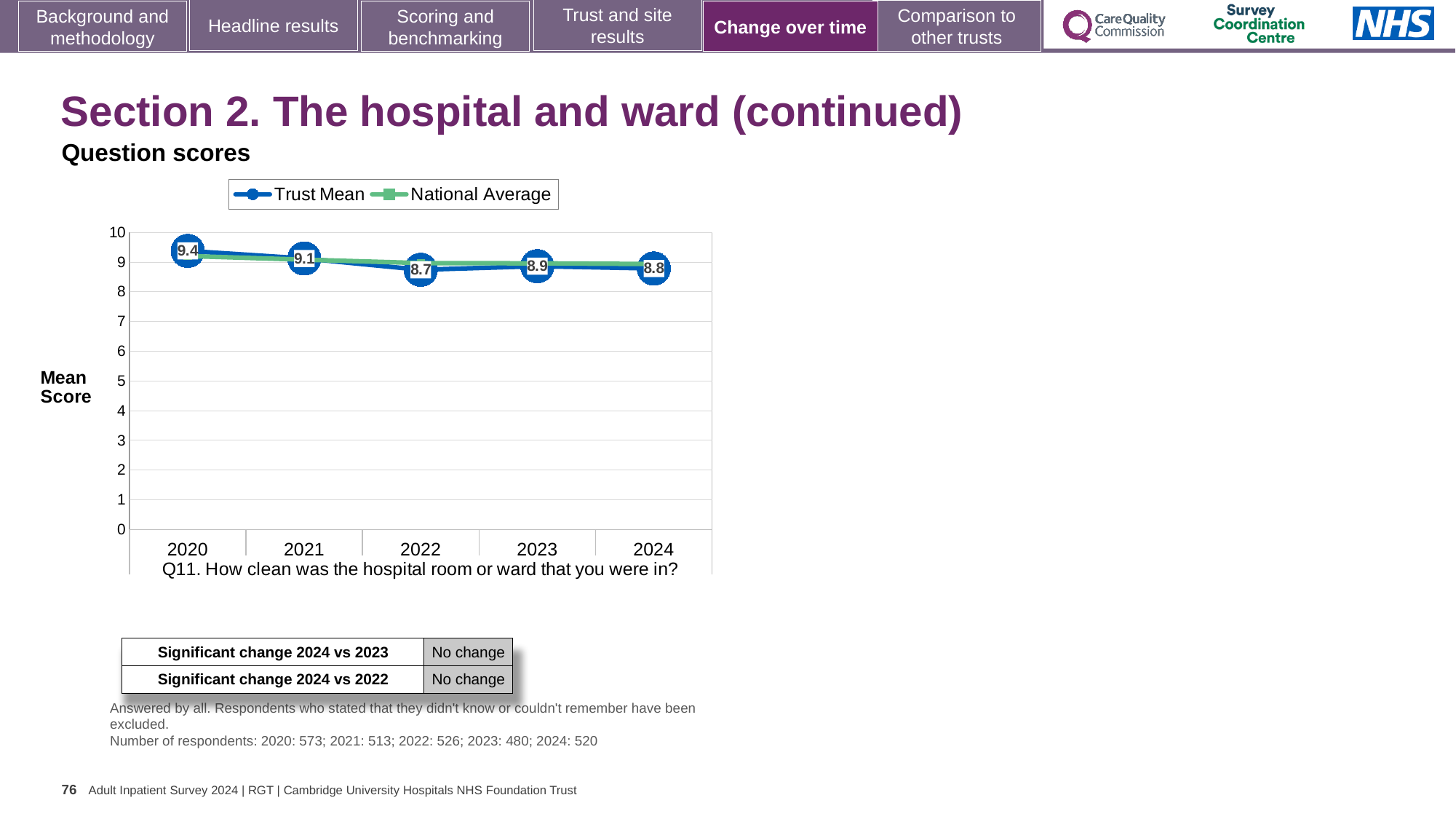
What kind of chart is shown on the slide? Line chart What is the Trust Mean score for 2024? 8.8 How many years are shown on the x axis of the chart? 5 Does the Trust Mean score rise or fall from 2020 to 2022? Fall What is the Trust Mean score for 2022? 8.7 What is the Trust Mean score for 2020? 9.4 What is the difference between the Trust Mean score in 2020 and in 2024? 0.6 In which year is the Trust Mean score lowest? 2022 How many series does the chart legend list? 2 Is the National Average value for 2024 greater or less than 8? greater In which year is the Trust Mean score highest? 2020 Which year has the larger Trust Mean score, 2021 or 2023? 2021